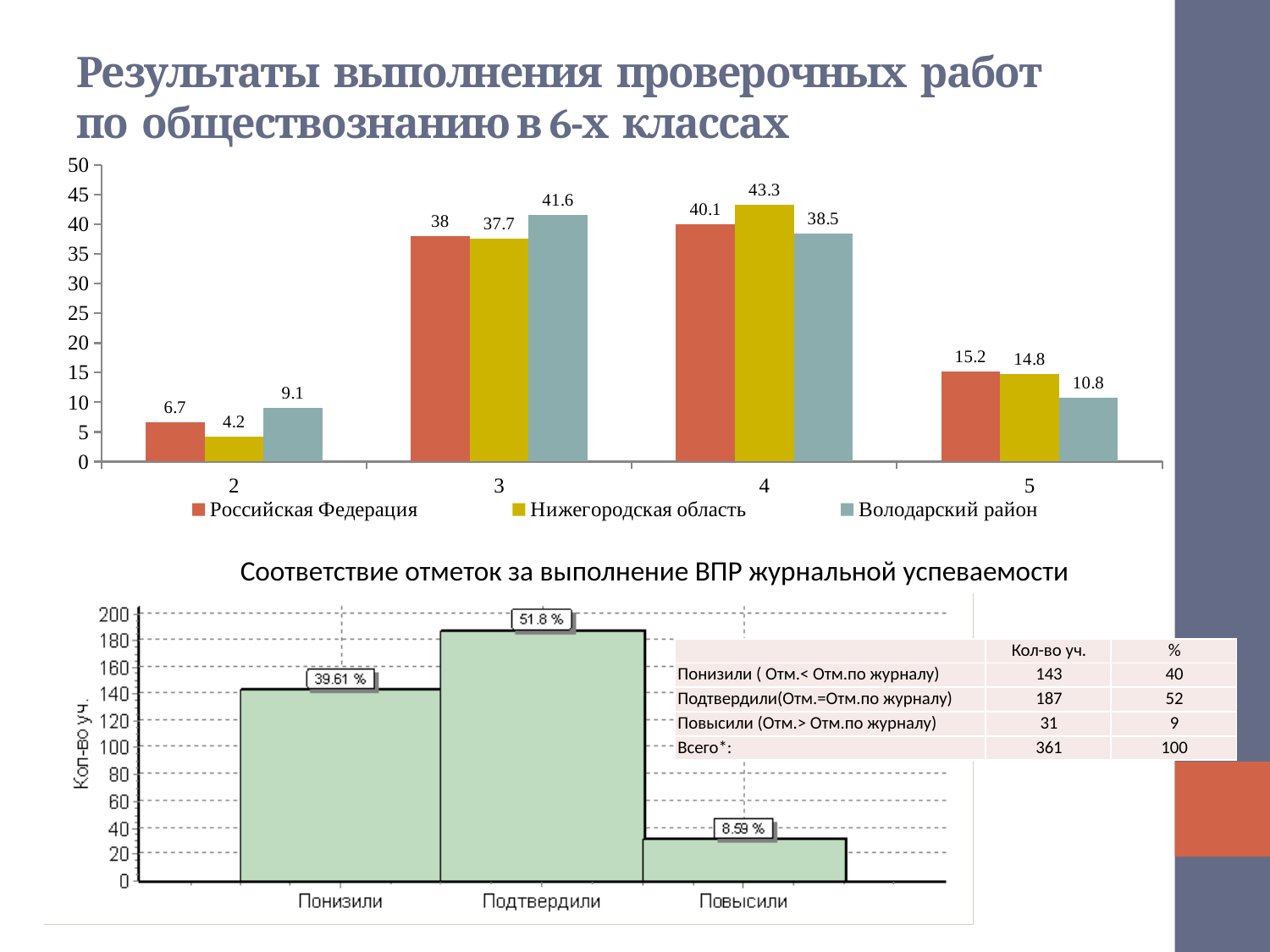
In the top chart, which category has the lowest value for Володарский район? 2 In the top chart, what is the value for Володарский район in category 3? 41.6 In the top chart, what is the value for Российская Федерация in category 5? 15.2 In the top chart, what is the value for Нижегородская область in category 2? 4.2 In the top chart, what is the difference between Нижегородская область and Российская Федерация in category 4? 3.2 In the top chart, which is larger in category 5: Российская Федерация or Володарский район? Российская Федерация In the top chart, which category has the highest value for Нижегородская область? 4 In the chart titled 'Соответствие отметок за выполнение ВПР журнальной успеваемости', what percentage label is shown on the Подтвердили bar? 51.8 % In the chart titled 'Соответствие отметок за выполнение ВПР журнальной успеваемости', which category has the lowest value? Повысили What kind of chart is the bottom chart titled 'Соответствие отметок за выполнение ВПР журнальной успеваемости'? bar chart How many series does the legend of the top chart list? 3 How many categories are shown on the x axis of the top chart? 4